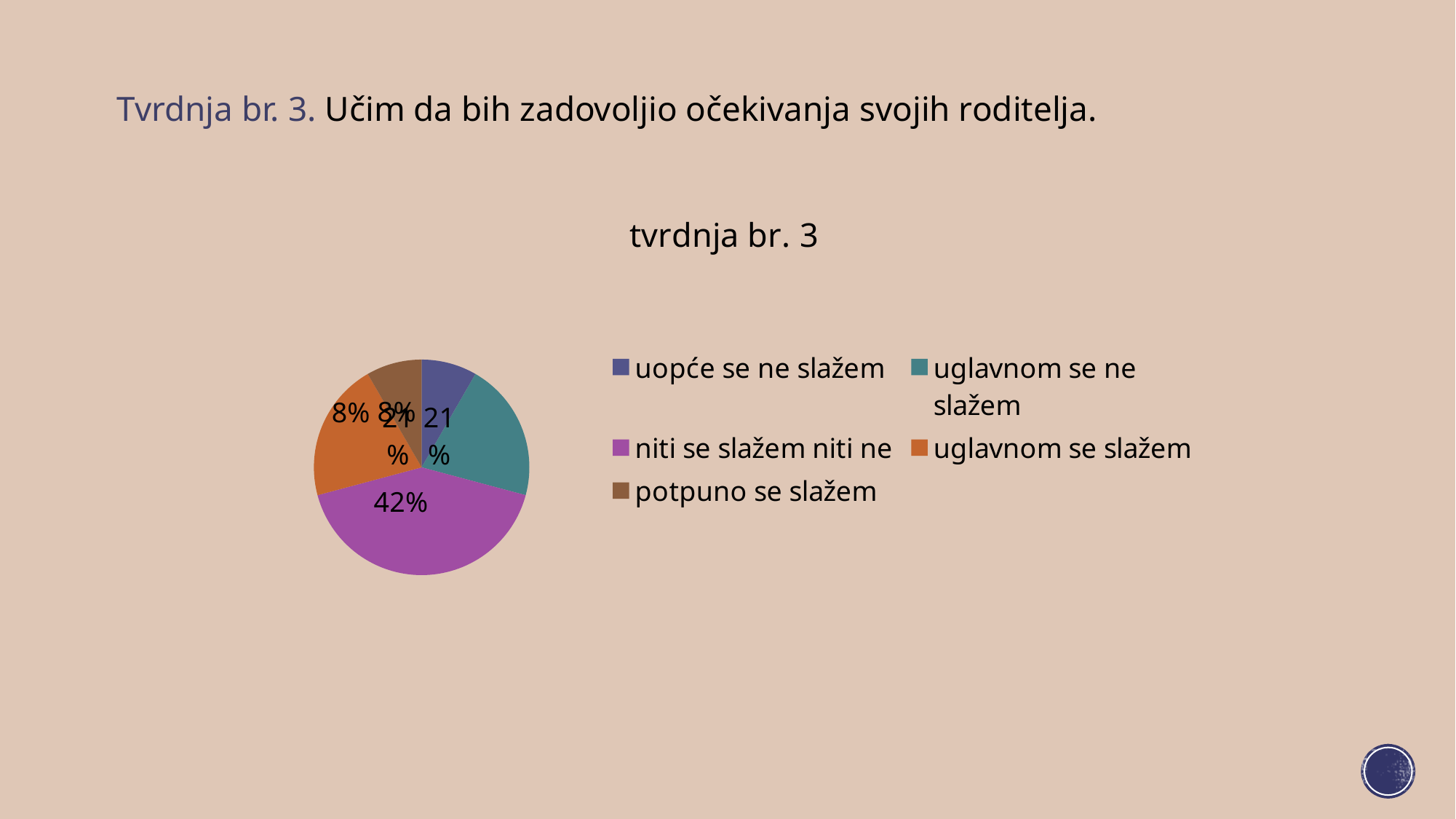
What share of the pie does "uglavnom se ne slažem" have? 21% What share of the pie does "uopće se ne slažem" have? 8% What share of the pie does "niti se slažem niti ne" have? 42% What is the title of the chart? tvrdnja br. 3 What is the difference between the share for "niti se slažem niti ne" and the share for "uglavnom se ne slažem"? 21% Which category has the largest slice of the pie? niti se slažem niti ne Which is larger: the slice for "niti se slažem niti ne" or the slice for "uglavnom se slažem"? niti se slažem niti ne What kind of chart is shown on the slide? pie chart Which colour represents "niti se slažem niti ne" in the legend? purple How many categories does the pie chart have? 5